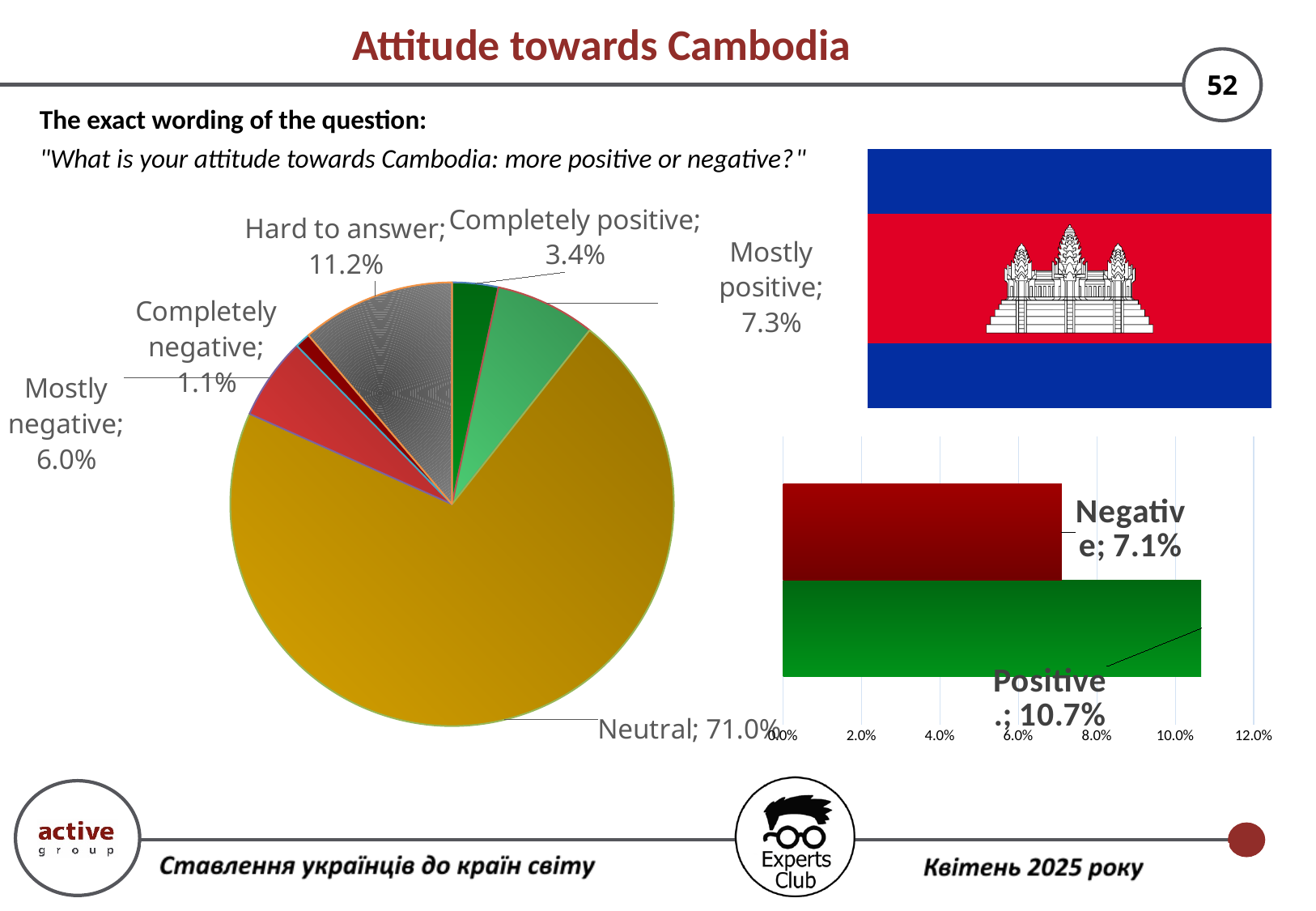
In the bar chart on the right, what is the value for "Positive"? 10.7% In the bar chart on the right, what is the difference between "Positive" and "Negative"? 3.6% In the pie chart, which is larger: "Mostly positive" or "Completely positive"? Mostly positive In the pie chart, what is the difference between "Mostly negative" and "Completely negative"? 4.9% In the pie chart, which category has the largest share? Neutral In the pie chart, what share of respondents answered "Neutral"? 71.0% In the pie chart, what is the value for "Hard to answer"? 11.2% In the pie chart, what is the value for "Mostly positive"? 7.3% In the bar chart on the right, what is the value for "Negative"? 7.1% In the pie chart, how many categories are shown? 6 What type of chart is shown on the right side of the slide? Bar chart In the pie chart, which category has the smallest share? Completely negative